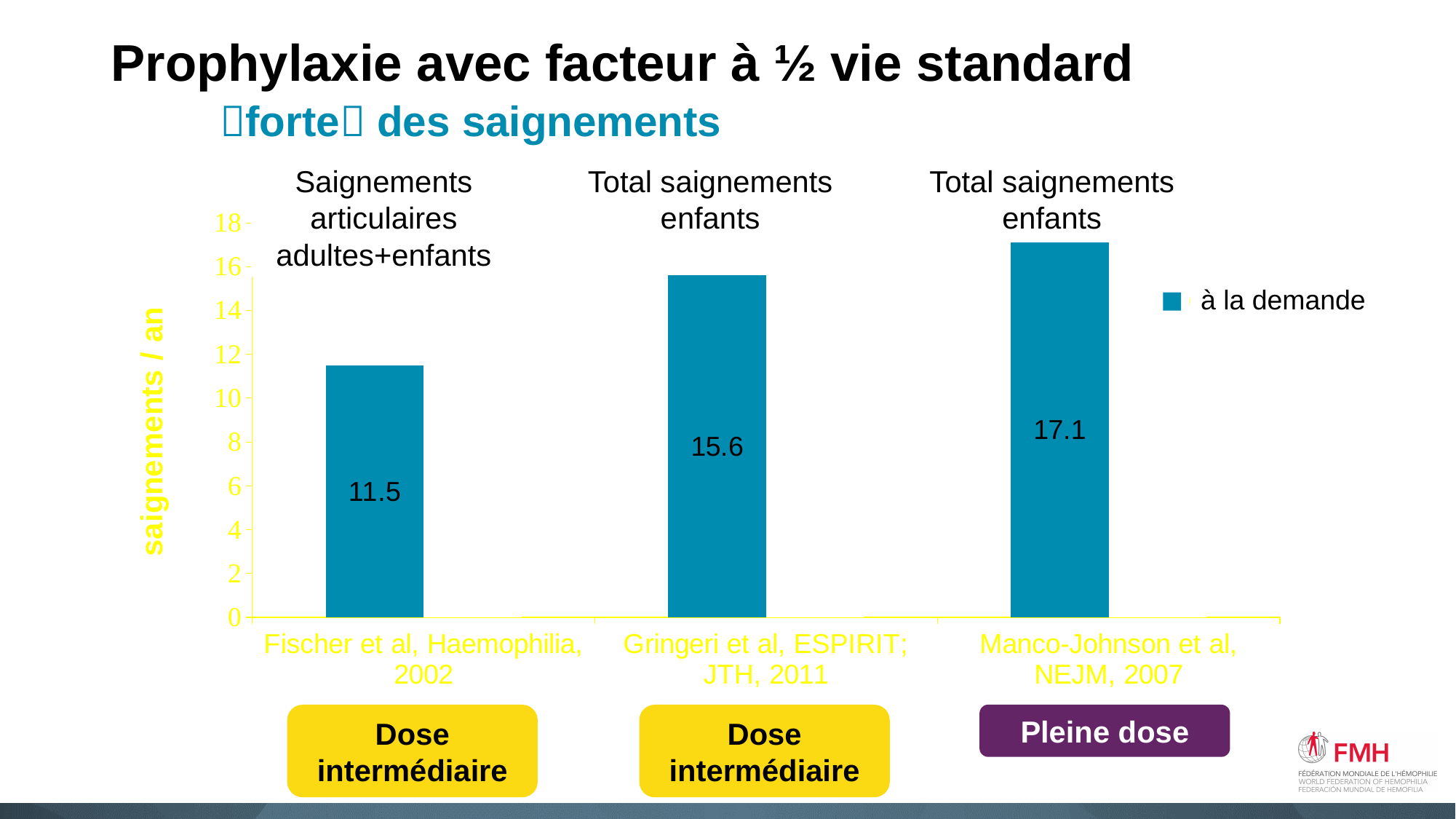
What is the label of the series shown in the legend? à la demande Which study has the highest number of saignements / an? Manco-Johnson et al, NEJM, 2007 What kind of chart is shown on the slide? bar chart What is the difference between the values for Manco-Johnson et al, NEJM, 2007 and Fischer et al, Haemophilia, 2002? 5.6 What is the value for Fischer et al, Haemophilia, 2002? 11.5 What is the difference between the values for Gringeri et al, ESPIRIT; JTH, 2011 and Fischer et al, Haemophilia, 2002? 4.1 Is the value for Fischer et al, Haemophilia, 2002 greater or less than 12? less What is the value for Gringeri et al, ESPIRIT; JTH, 2011? 15.6 Which is larger, the value for Gringeri et al, ESPIRIT; JTH, 2011 or the value for Manco-Johnson et al, NEJM, 2007? Manco-Johnson et al, NEJM, 2007 How many bars are shown in the chart? 3 Which study has the lowest number of saignements / an? Fischer et al, Haemophilia, 2002 What is the value for Manco-Johnson et al, NEJM, 2007? 17.1